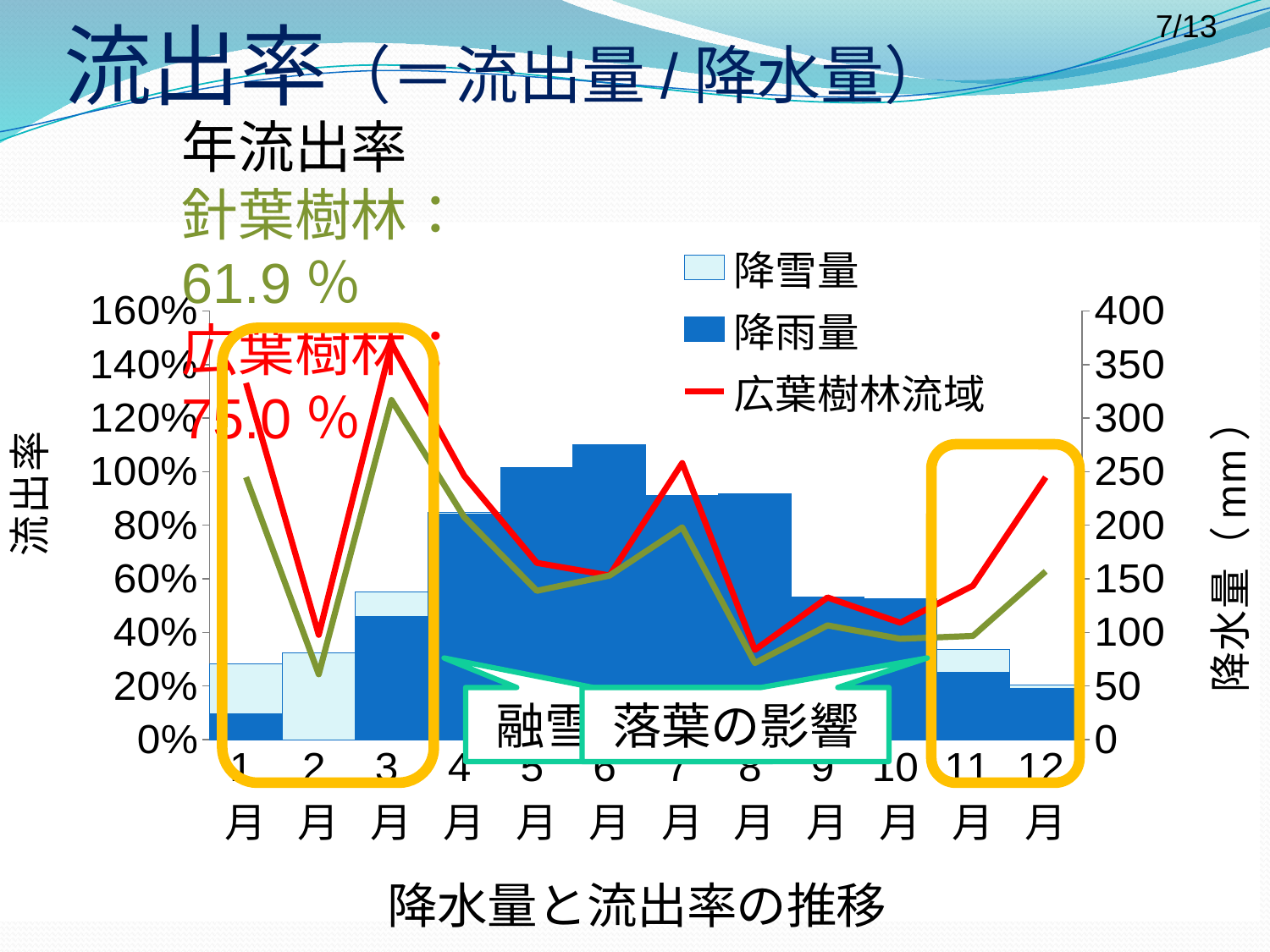
Is the 広葉樹林流域 value for 8月 greater or less than 60%? less Which is larger for 広葉樹林流域: the value for 2月 or the value for 3月? 3月 Is the 広葉樹林流域 value for 3月 greater or less than 120%? greater What is the label of the right-hand vertical axis of the chart? 降水量（mm） Which month has the tallest total precipitation bar? 6月 Is the total precipitation bar (降雪量 plus 降雨量) for 6月 greater or less than 250 mm? greater What is the title of the chart? 降水量と流出率の推移 What kind of chart is shown on the slide? A combined bar and line chart How many months are shown along the x axis of the chart? 12 Does the 広葉樹林流域 line rise or fall from 10月 to 12月? rise